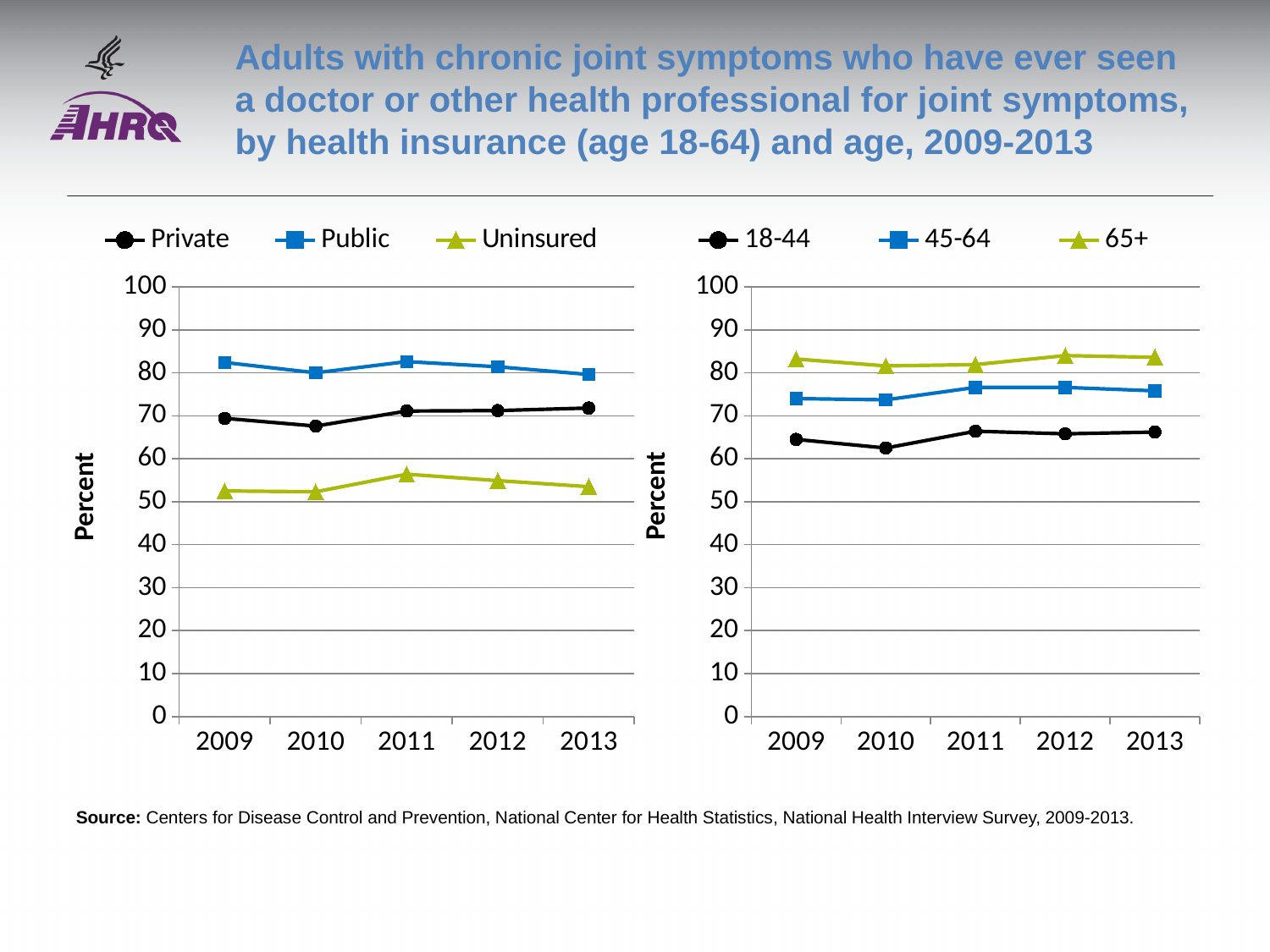
What kind of chart is the left chart (by health insurance)? line chart In the right chart (by age), which age group has the lowest value in 2010? 18-44 In the right chart (by age), is the value for 18-44 in 2010 greater or less than 60? greater What is the label on the y axis of the right chart (by age)? Percent In the right chart (by age), which is larger in 2013, the value for 45-64 or the value for 18-44? 45-64 In the left chart (by health insurance), is the value for Uninsured in 2011 greater or less than 60? less In the right chart (by age), is the value for 65+ in 2012 greater or less than 80? greater How many years are shown on the x axis of the left chart (by health insurance)? 5 In the left chart (by health insurance), which insurance group has the highest value in 2013? Public In the left chart (by health insurance), which insurance group has the lowest value in 2011? Uninsured How many series does the legend of the left chart (by health insurance) list? 3